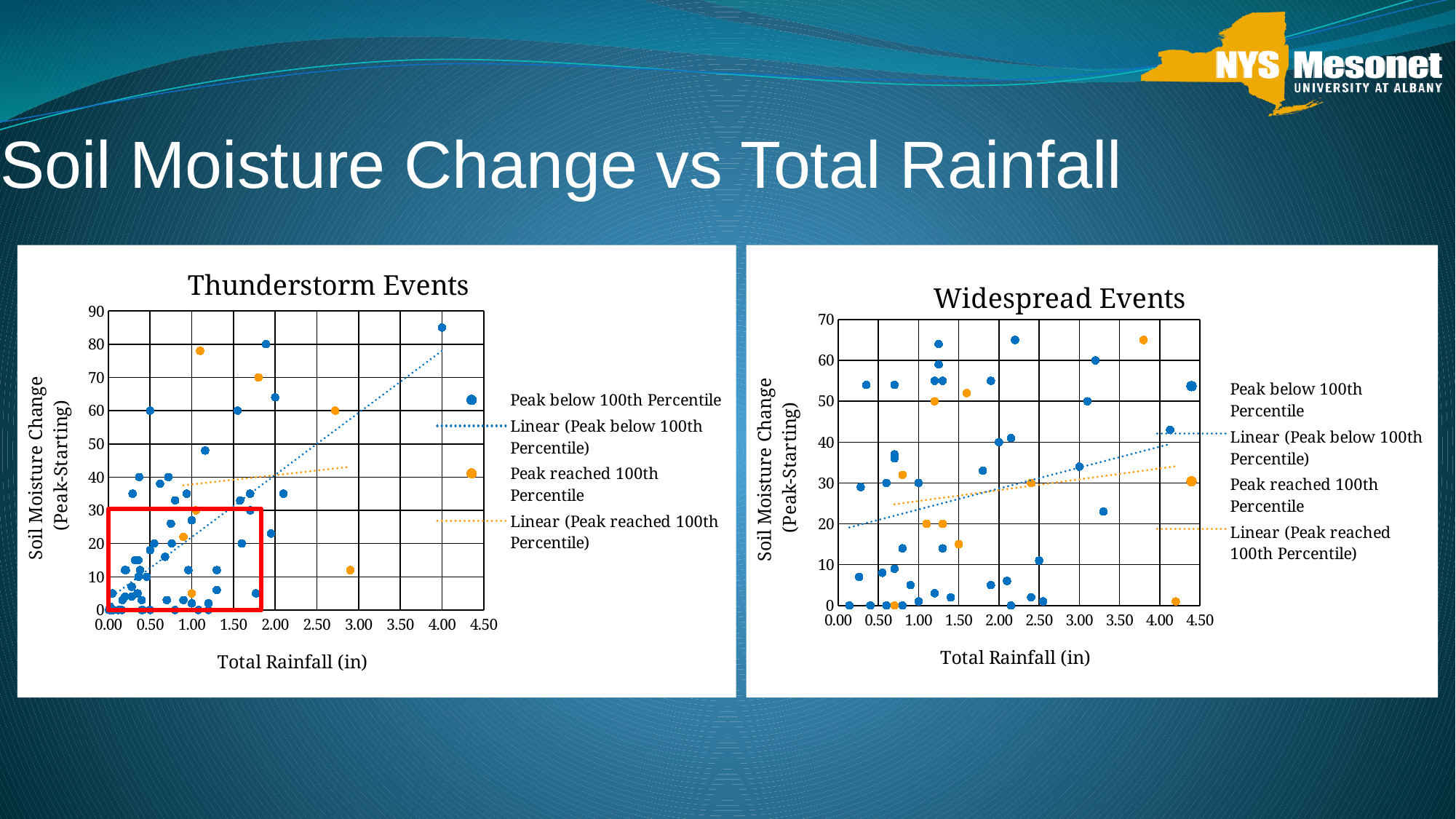
What kind of chart is the Widespread Events chart? Scatter chart What is the maximum value shown on the y-axis of the Thunderstorm Events chart? 90 In the Thunderstorm Events chart, is the highest plotted soil moisture change greater or less than 80? greater What kind of chart is the Thunderstorm Events chart? Scatter chart In the Thunderstorm Events chart, which series is plotted in orange? Peak reached 100th Percentile What is the x-axis title of the Widespread Events chart? Total Rainfall (in) In the Widespread Events chart, does the dotted linear trendline for Peak reached 100th Percentile rise or fall as total rainfall increases? Rises How many entries does the legend of the Widespread Events chart list? 4 In the Thunderstorm Events chart, does the dotted linear trendline for Peak below 100th Percentile rise or fall as total rainfall increases? Rises In the Widespread Events chart, is the highest plotted soil moisture change greater or less than 60? greater How many entries does the legend of the Thunderstorm Events chart list? 4